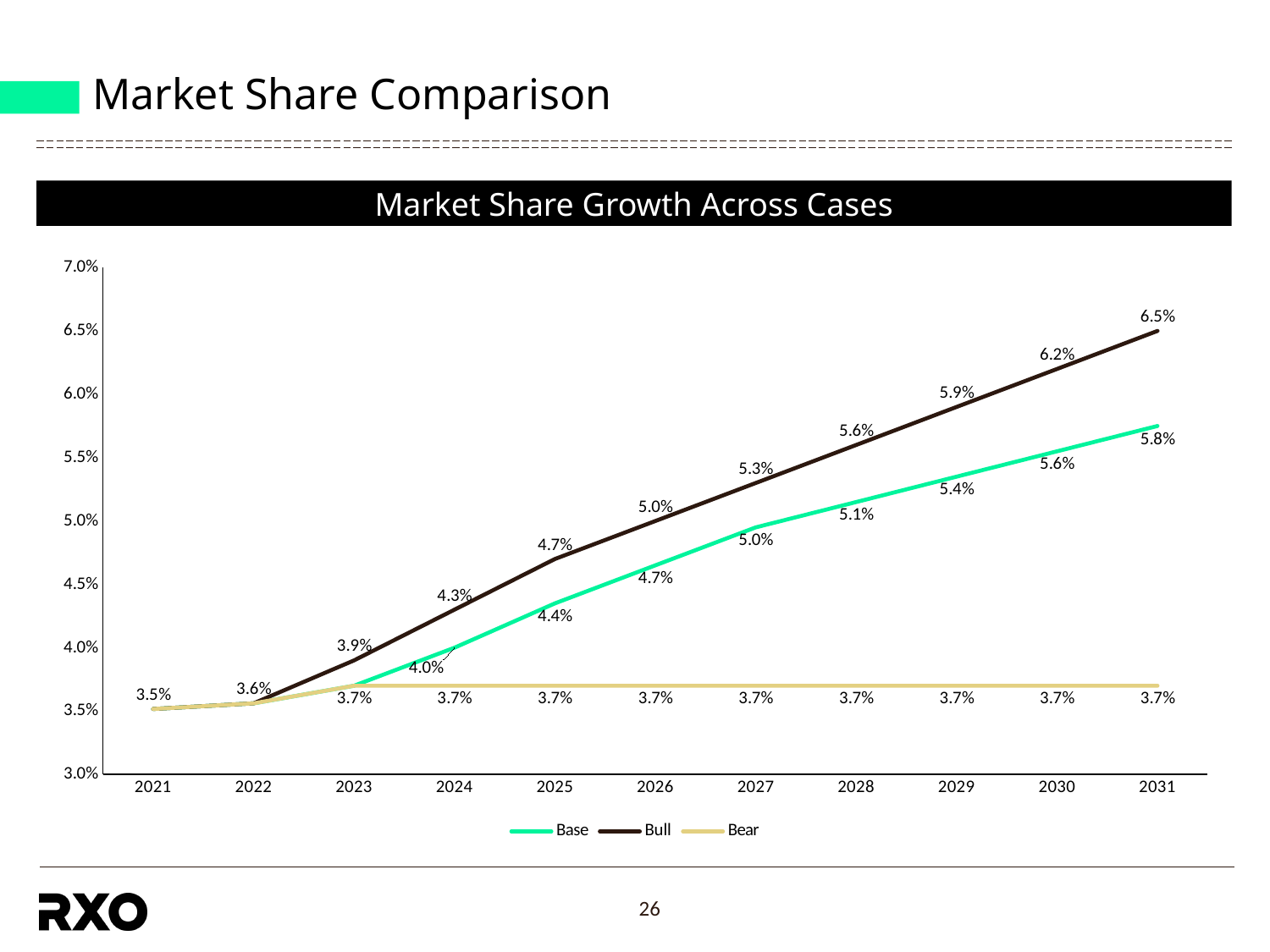
Does the Bull case line rise or fall from 2021 to 2031? rise Which series has the higher value in 2028, Bull or Base? Bull What kind of chart is shown on the slide? line chart What is the Base case market share in 2031? 5.8% What is the Bull case market share in 2031? 6.5% What is the Base case market share in 2025? 4.4% How many series does the legend list? 3 Which series has the highest value in 2031? Bull What is the difference between the Bull and Base case values in 2031? 0.7% What is the Bull case market share in 2027? 5.3% What is the Bear case market share in 2030? 3.7% How many years are shown on the x axis? 11